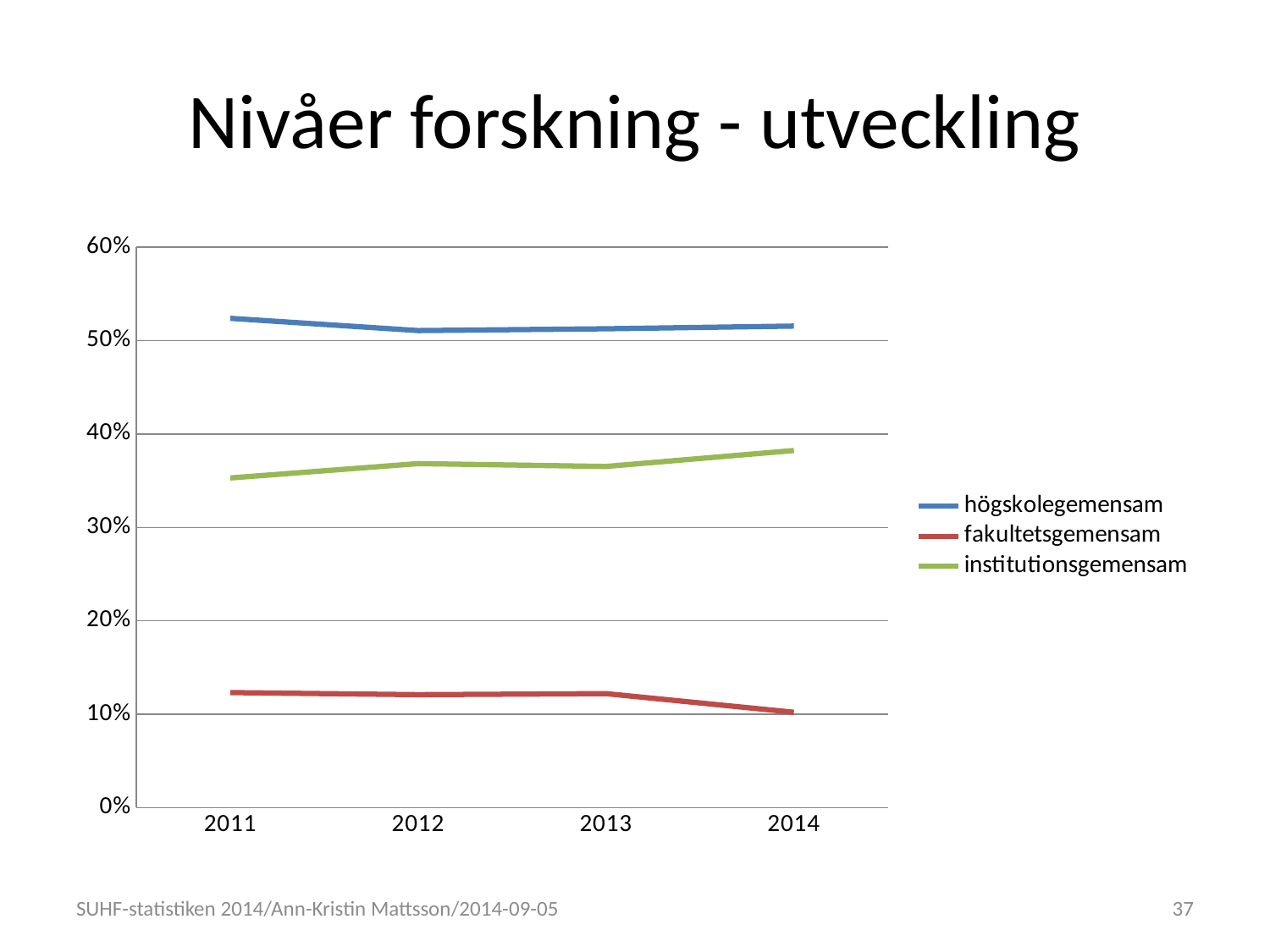
How many series does the legend list? 3 Which series has the highest value in 2014? högskolegemensam Is the value for institutionsgemensam in 2014 greater or less than 40%? less What kind of chart is shown on the slide? line chart What is the title of the slide? Nivåer forskning - utveckling Which is larger in 2012, institutionsgemensam or fakultetsgemensam? institutionsgemensam Is the value for fakultetsgemensam in 2013 greater or less than 10%? greater Does the fakultetsgemensam line rise or fall between 2013 and 2014? fall Does the institutionsgemensam line rise or fall between 2011 and 2014 overall? rise How many years are shown on the x axis? 4 Which series has the lowest value in 2011? fakultetsgemensam Is the value for högskolegemensam in 2011 greater or less than 50%? greater